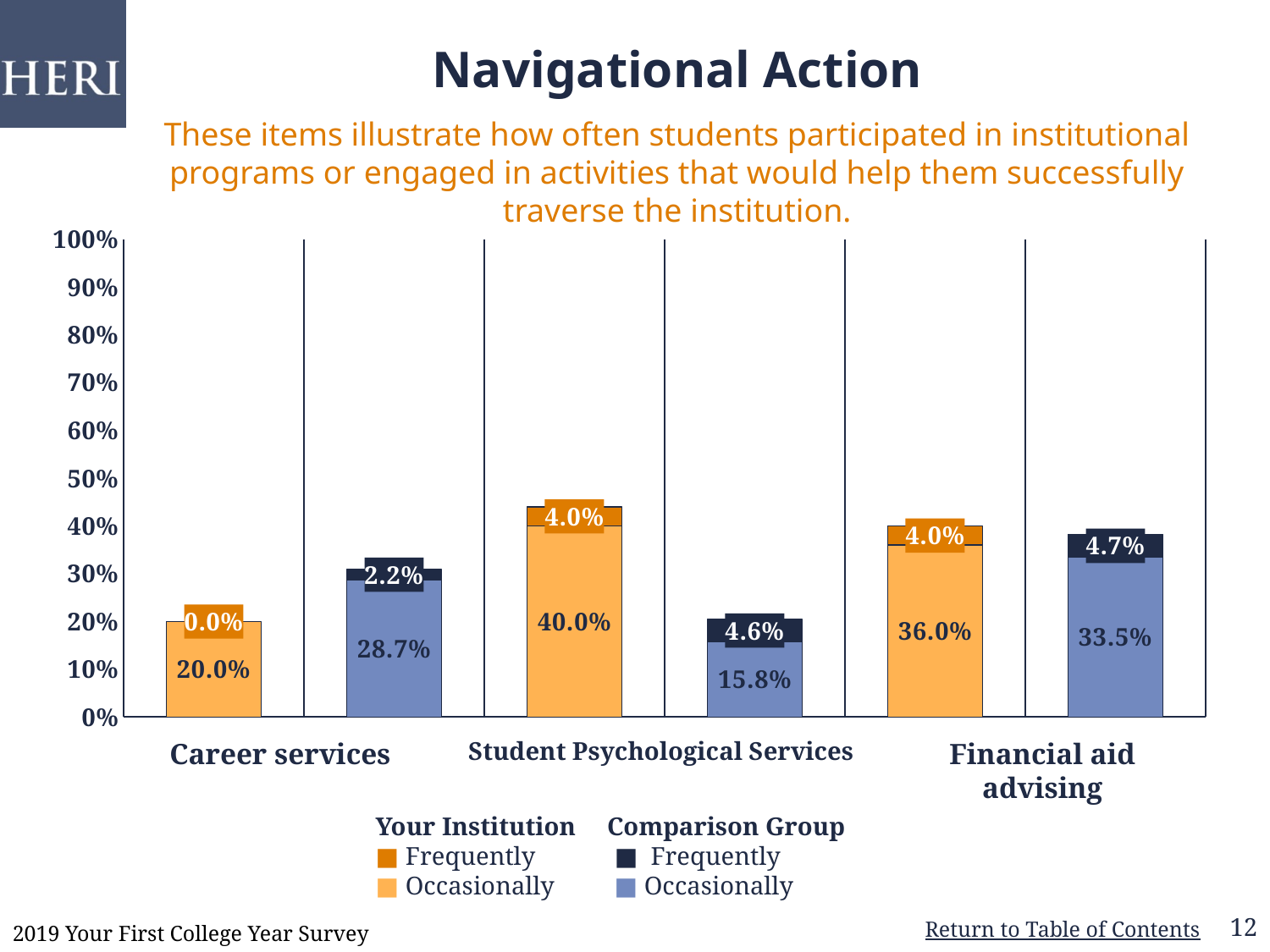
Which category has the highest 'Occasionally' value for Your Institution? Student Psychological Services What percentage of the Comparison Group occasionally used Career services? 28.7% What is the total height of the Comparison Group stacked bar for Career services? 30.9% Which category has the lowest 'Occasionally' value for the Comparison Group? Student Psychological Services What percentage of students at Your Institution occasionally used Career services? 20.0% How many series does the legend list? 4 What percentage of students at Your Institution occasionally used Financial aid advising? 36.0% What kind of chart is shown on the slide? Stacked bar chart What is the difference between the 'Occasionally' values for Your Institution and the Comparison Group for Student Psychological Services? 24.2% Which is larger for Financial aid advising: the 'Frequently' value for Your Institution or for the Comparison Group? Comparison Group What percentage of the Comparison Group frequently used Student Psychological Services? 4.6% What is the total height of the Your Institution stacked bar for Student Psychological Services? 44.0%